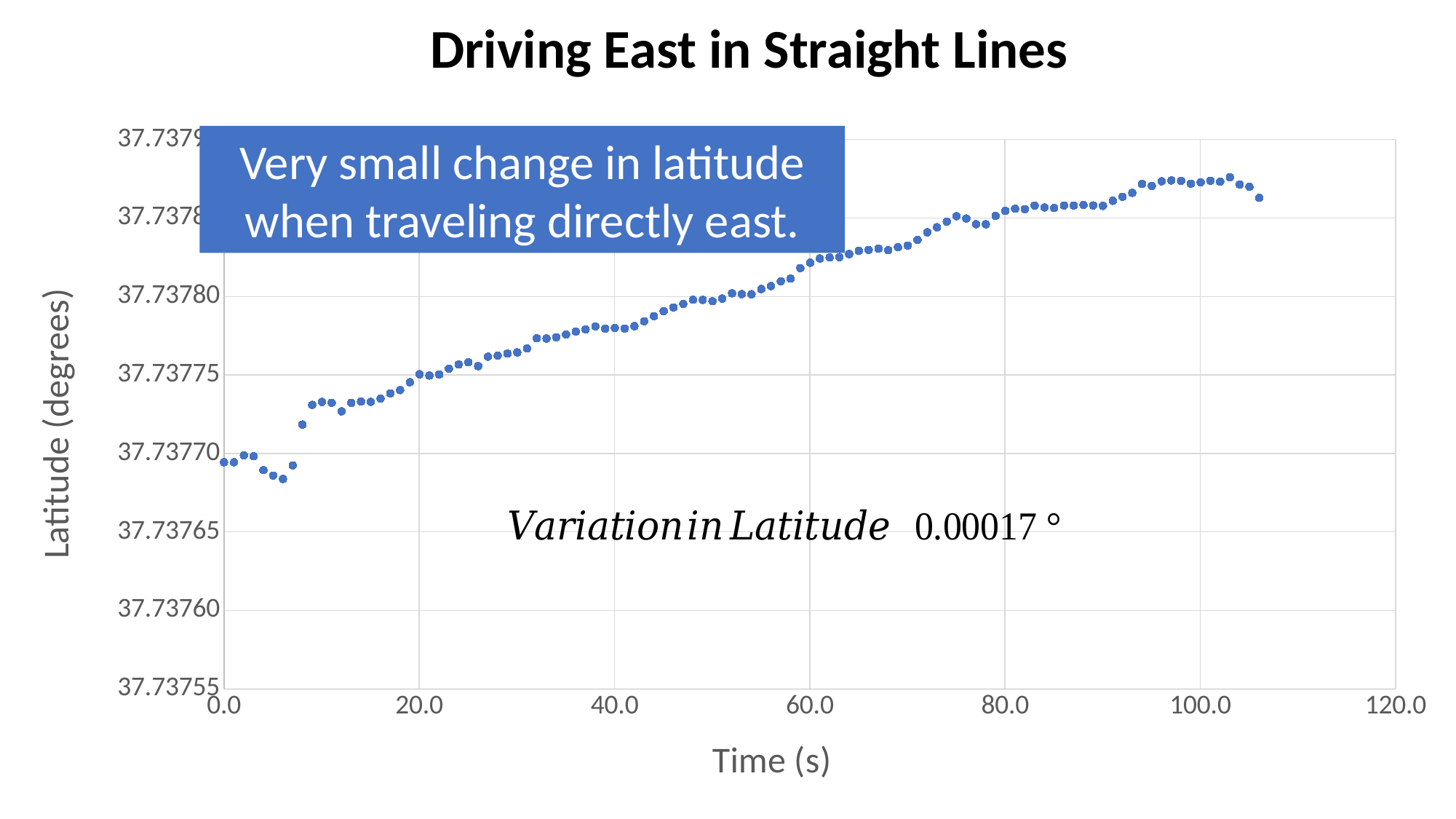
Which has the higher latitude: the point at time 20.0 s or the point at time 60.0 s? 60.0 s What kind of chart is shown on the slide? scatter chart Is the latitude value at time 100.0 s greater or less than 37.73785? greater Is the latitude value at time 80.0 s greater or less than 37.73780? greater Which has the lower latitude: the point at time 0.0 s or the point at time 100.0 s? 0.0 s Is the latitude value at time 0.0 s greater or less than 37.73775? less Do the latitude values generally rise or fall as time increases along the x axis? rise What variation in latitude is stated on the slide? 0.00017 ° What is the title of the chart? Driving East in Straight Lines